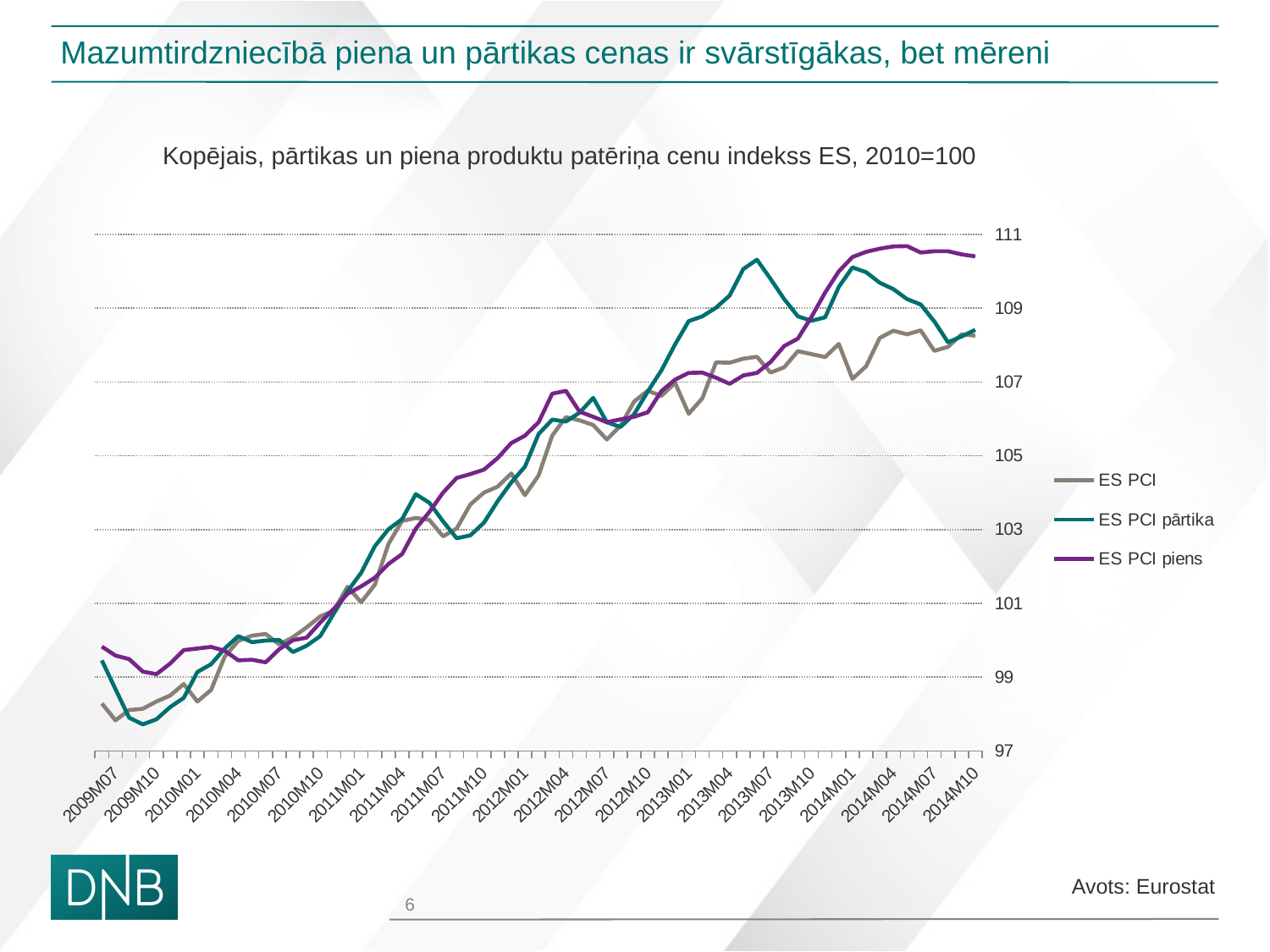
At 2013M07, which series is higher: ES PCI pārtika or ES PCI? ES PCI pārtika At 2014M10, which series is higher: ES PCI piens or ES PCI? ES PCI piens Is the value of ES PCI at 2011M01 greater or less than 103? less Is the value of ES PCI pārtika at 2009M10 greater or less than 99? less Is the value of ES PCI at 2012M07 greater or less than 107? less Does the ES PCI piens series rise or fall overall from 2009M07 to 2014M10? rise What kind of chart is shown on the slide? line chart How many series does the legend list? 3 What is the title of the chart? Kopējais, pārtikas un piena produktu patēriņa cenu indekss ES, 2010=100 What are the series names listed in the legend? ES PCI, ES PCI pārtika, ES PCI piens